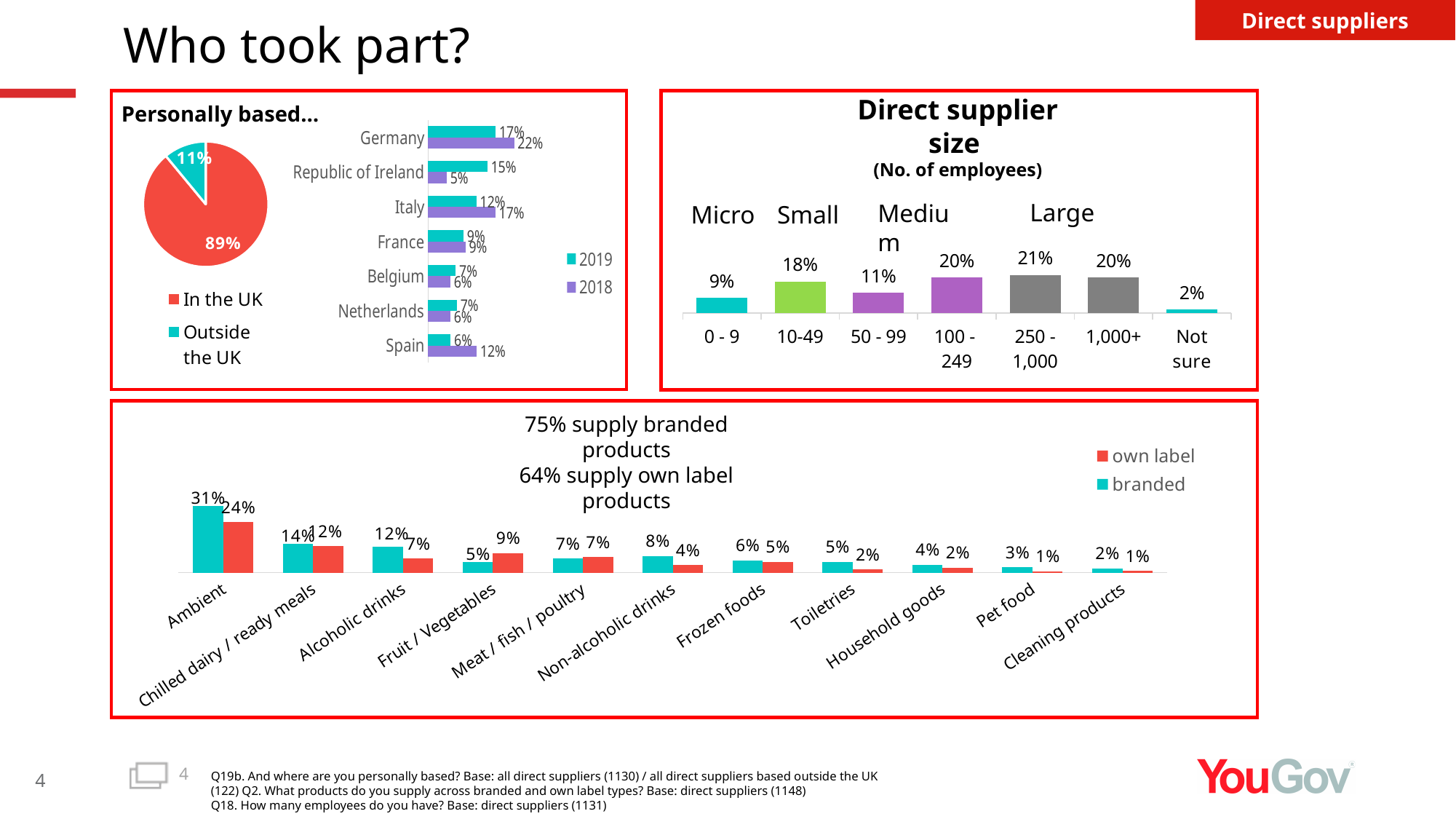
In the bottom product chart, what is the branded value for Ambient? 31% In the 'Direct supplier size' chart, which employee band has the highest value? 250 - 1,000 In the country bar chart in the top-left box, what is the 2019 value for Republic of Ireland? 15% In the country bar chart in the top-left box, what is the difference between the 2018 and 2019 values for Spain? 6% In the country bar chart in the top-left box, what is the 2018 value for Germany? 22% In the bottom product chart, how many product categories are shown? 11 In the 'Personally based...' pie chart, what share of respondents are based in the UK? 89% In the country bar chart in the top-left box, how many series does the legend list? 2 In the 'Direct supplier size' chart, what is the value for 10-49 employees? 18% In the 'Direct supplier size' chart, how many categories are shown on the x axis? 7 In the 'Personally based...' pie chart, what share of respondents are based outside the UK? 11% In the bottom product chart, which is larger for Fruit / Vegetables: own label or branded? own label